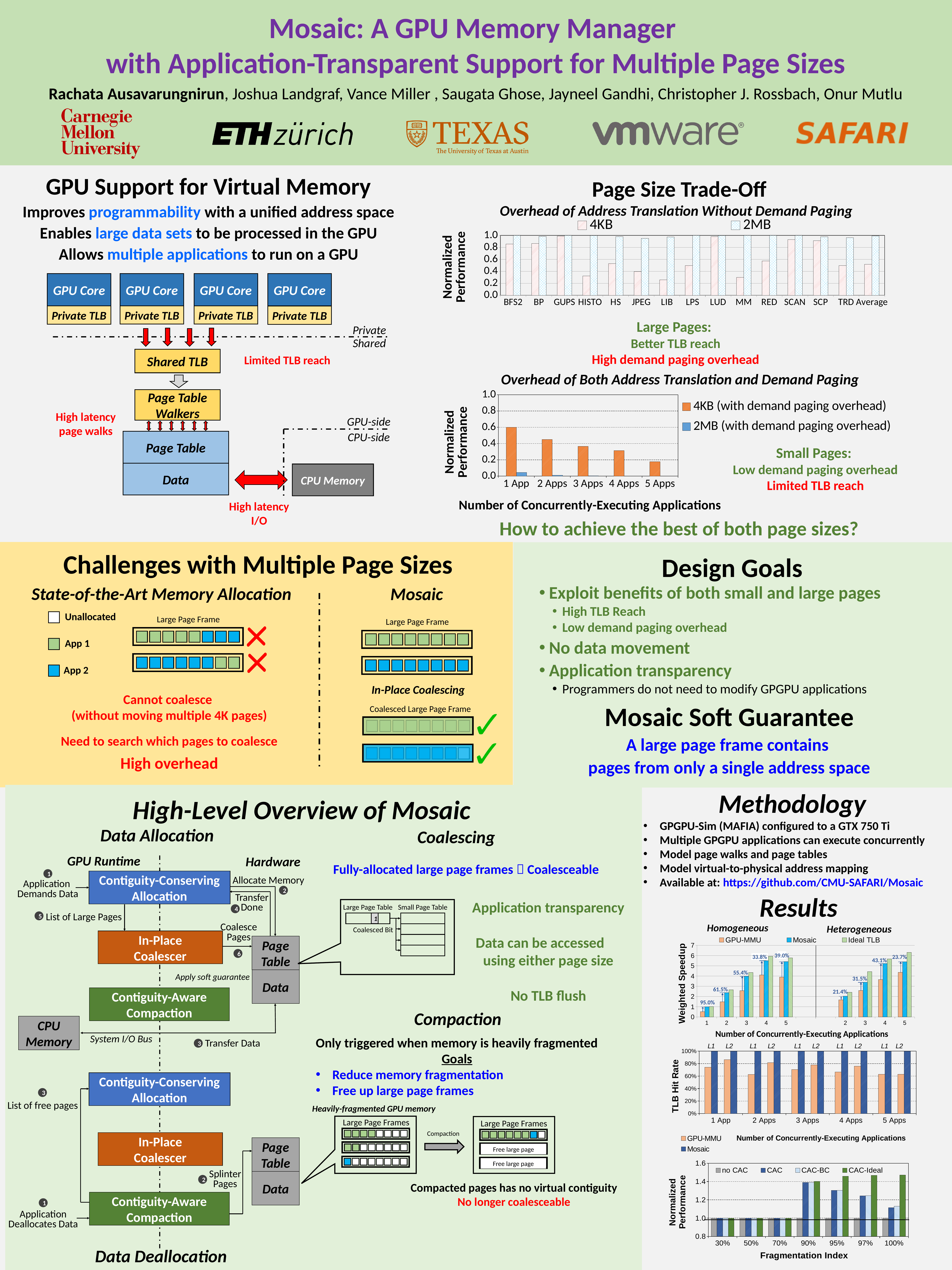
In the Weighted Speedup results chart, what percentage label is shown for 4 concurrently-executing applications in the Heterogeneous group? 43.1% In the 'Overhead of Address Translation Without Demand Paging' chart, how many categories are shown on the x axis? 15 In the 'Overhead of Address Translation Without Demand Paging' chart, how many series does the legend list? 2 In the 'Overhead of Both Address Translation and Demand Paging' chart, for 1 App, which is larger: the 4KB bar or the 2MB bar? 4KB In the Normalized Performance vs Fragmentation Index chart, how many series does the legend list? 4 What kind of chart is the 'Overhead of Address Translation Without Demand Paging' chart? bar chart In the 'Overhead of Address Translation Without Demand Paging' chart, is the 4KB value for HISTO greater or less than 0.4? less In the Weighted Speedup results chart, how many series does the legend list? 3 In the 'Overhead of Both Address Translation and Demand Paging' chart, do the 4KB values rise or fall as the number of applications increases? fall In the Weighted Speedup results chart, what percentage label is shown for 1 concurrently-executing application in the Homogeneous group? 95.0% In the 'Overhead of Both Address Translation and Demand Paging' chart, which number of applications has the highest 4KB value? 1 App In the 'Overhead of Both Address Translation and Demand Paging' chart, is the 4KB value for 1 App greater or less than 0.4? greater